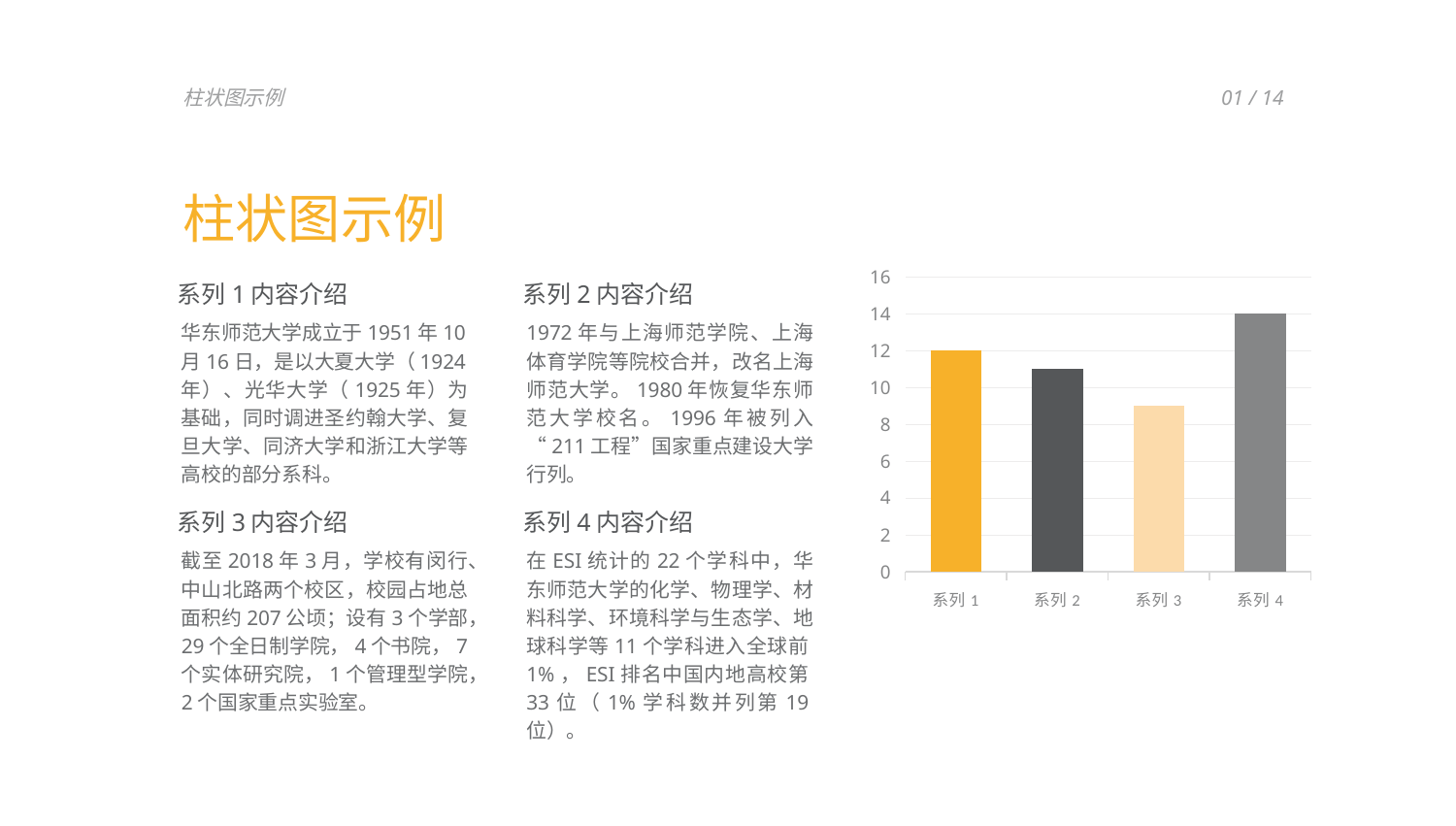
What is the difference between the values for 系列 4 and 系列 1? 2 Which category has the highest bar? 系列 4 What kind of chart is shown on the slide? bar chart What is the value for 系列 1? 12 What is the highest value shown on the vertical axis? 16 Is the value for 系列 3 greater or less than 10? less Which category has the lowest bar? 系列 3 What is the value for 系列 4? 14 How many categories are shown on the chart? 4 Which is larger, the value for 系列 1 or the value for 系列 3? 系列 1 Is the value for 系列 2 greater or less than 10? greater Is the value for 系列 4 greater or less than 12? greater